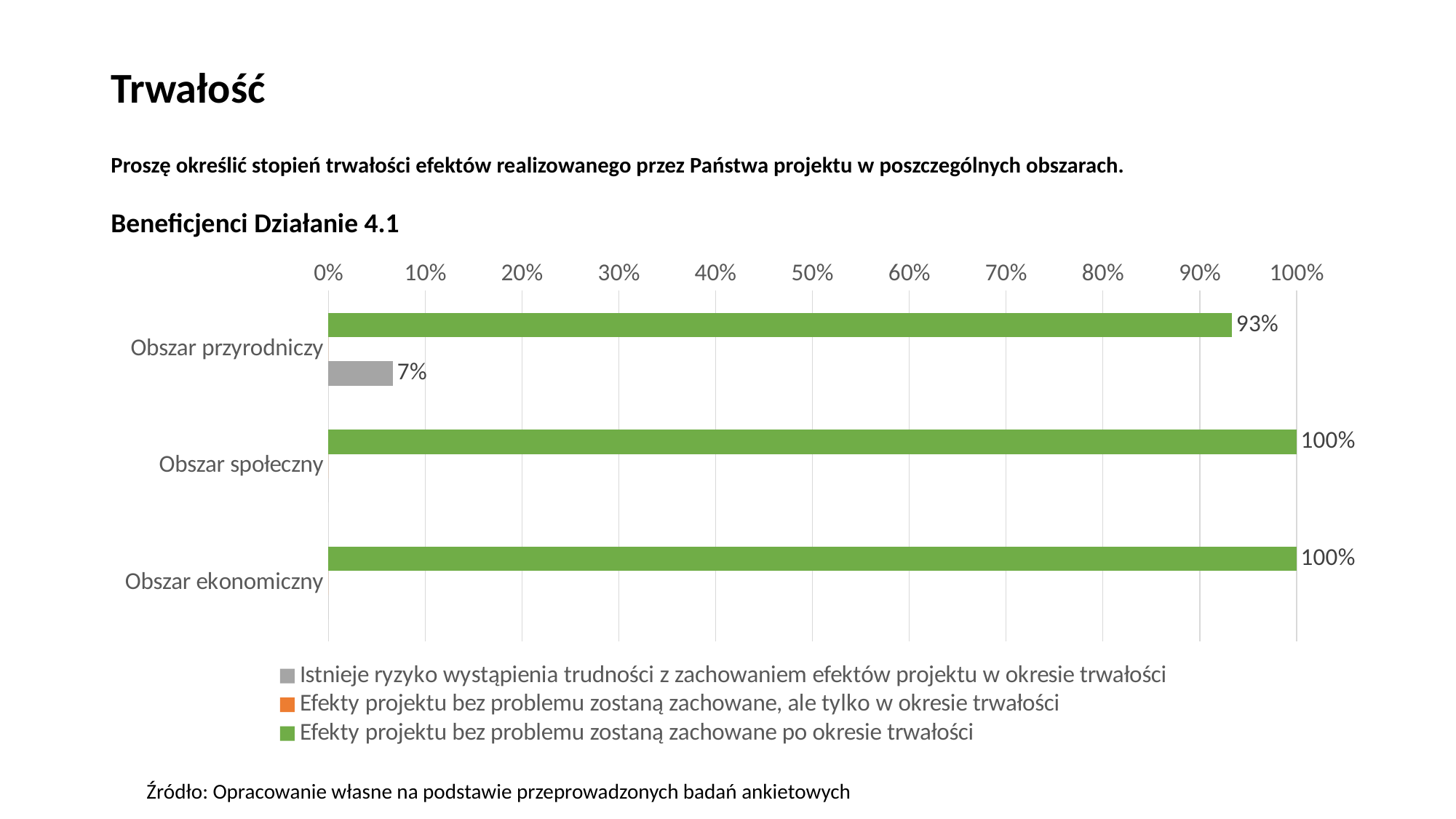
What is the difference between the green and grey values for Obszar przyrodniczy? 86% What is the value of the green series for Obszar społeczny? 100% Which is larger for Obszar przyrodniczy: the green series value or the grey series value? the green series (93%) How many categories are shown on the vertical axis of the chart? 3 What is the value of the green series for Obszar ekonomiczny? 100% What is the value of the grey series (Istnieje ryzyko wystąpienia trudności z zachowaniem efektów projektu w okresie trwałości) for Obszar przyrodniczy? 7% Which category has the lowest value for the green series (Efekty projektu bez problemu zostaną zachowane po okresie trwałości)? Obszar przyrodniczy What is the value of the green series (Efekty projektu bez problemu zostaną zachowane po okresie trwałości) for Obszar przyrodniczy? 93% How many series does the legend list? 3 What kind of chart is shown on the slide? bar chart What is the title of the chart? Beneficjenci Działanie 4.1 Is the grey series value for Obszar przyrodniczy greater or less than 10%? less